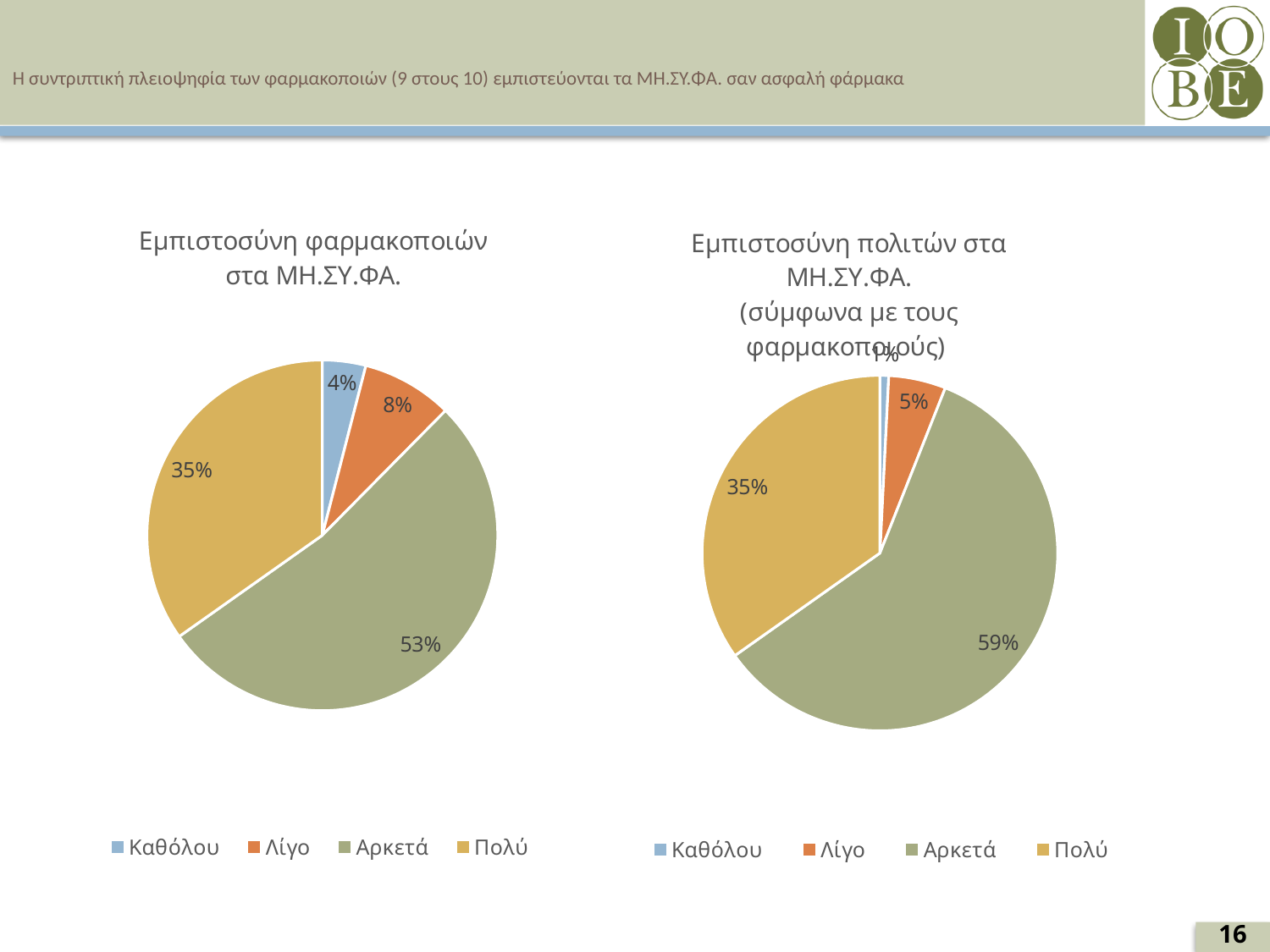
In the left chart (Εμπιστοσύνη φαρμακοποιών στα ΜΗ.ΣΥ.ΦΑ.), which category has the smallest slice? Καθόλου Which colour represents 'Πολύ' in the left chart (Εμπιστοσύνη φαρμακοποιών στα ΜΗ.ΣΥ.ΦΑ.)? Yellow In the left chart (Εμπιστοσύνη φαρμακοποιών στα ΜΗ.ΣΥ.ΦΑ.), which category has the largest slice? Αρκετά In the right chart (Εμπιστοσύνη πολιτών στα ΜΗ.ΣΥ.ΦΑ.), which category has the smallest slice? Καθόλου In the right chart (Εμπιστοσύνη πολιτών στα ΜΗ.ΣΥ.ΦΑ.), what is the value for 'Λίγο'? 5% In the right chart (Εμπιστοσύνη πολιτών στα ΜΗ.ΣΥ.ΦΑ.), what share does 'Αρκετά' have? 59% How many categories does the legend of the right chart (Εμπιστοσύνη πολιτών στα ΜΗ.ΣΥ.ΦΑ.) list? 4 What kind of chart is the left chart, 'Εμπιστοσύνη φαρμακοποιών στα ΜΗ.ΣΥ.ΦΑ.'? Pie chart In the left chart (Εμπιστοσύνη φαρμακοποιών στα ΜΗ.ΣΥ.ΦΑ.), what is the value for 'Καθόλου'? 4% In the left chart (Εμπιστοσύνη φαρμακοποιών στα ΜΗ.ΣΥ.ΦΑ.), what is the difference between 'Αρκετά' and 'Πολύ'? 18% In the left chart (Εμπιστοσύνη φαρμακοποιών στα ΜΗ.ΣΥ.ΦΑ.), what share does 'Αρκετά' have? 53% In the right chart (Εμπιστοσύνη πολιτών στα ΜΗ.ΣΥ.ΦΑ.), which is larger, 'Πολύ' or 'Αρκετά'? Αρκετά